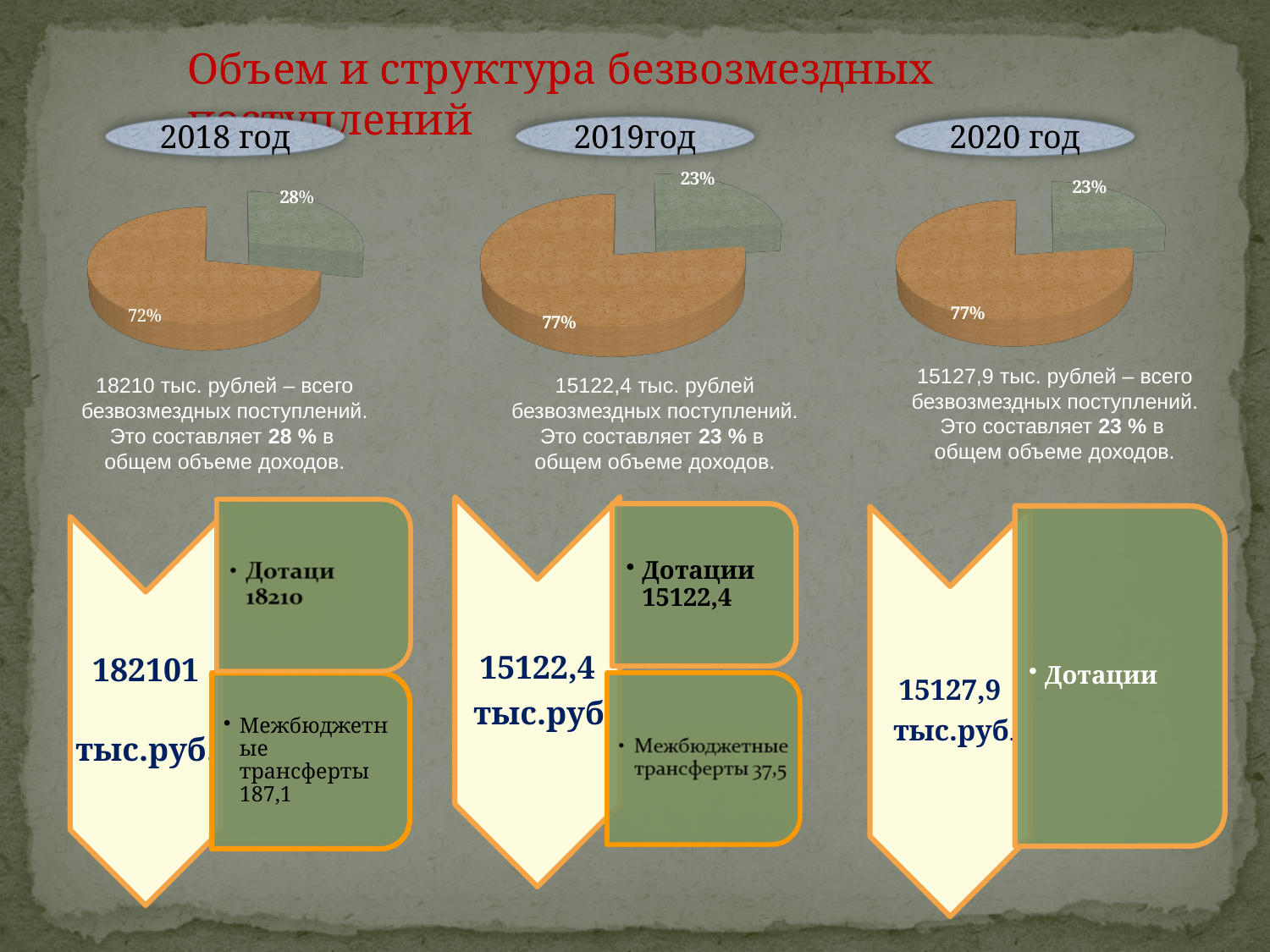
In the "2018 год" pie chart, what percentage is shown on the smaller (green) slice? 28% In the "2018 год" pie chart, how many slices are there? 2 In the "2020 год" pie chart, what percentage is shown on the brown slice? 77% Which is larger: the green slice in the "2018 год" pie chart or the green slice in the "2019год" pie chart? The green slice in the 2018 год chart (28%) What kind of chart is shown under the heading "2018 год"? Pie chart In the "2019год" pie chart, what percentage is shown on the green slice? 23% In the "2019год" pie chart, which slice is the largest, the brown one or the green one? The brown one (77%) In the "2018 год" pie chart, what percentage is shown on the larger (brown) slice? 72% Does the share of the green slice rise or fall from the "2018 год" pie chart to the "2019год" pie chart? Fall In the "2020 год" pie chart, what is the difference in percentage points between the 77% slice and the 23% slice? 54 percentage points How many pie charts are on the slide? 3 In the "2018 год" pie chart, what is the difference in percentage points between the brown slice and the green slice? 44 percentage points